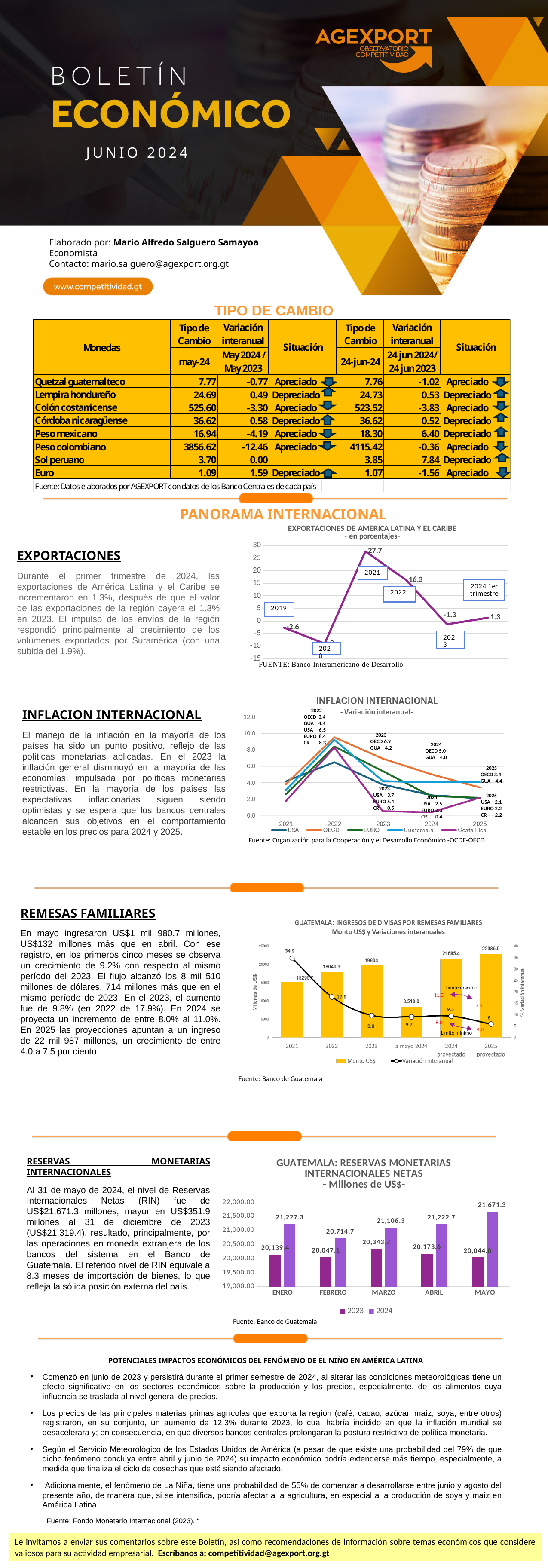
In the 'GUATEMALA: RESERVAS MONETARIAS INTERNACIONALES NETAS' chart, what is the 2024 value for MAYO? 21,671.3 In the 'EXPORTACIONES DE AMERICA LATINA Y EL CARIBE' chart, what is the value for 2023? -1.3 What kind of chart is the 'EXPORTACIONES DE AMERICA LATINA Y EL CARIBE' chart? line chart In the 'GUATEMALA: INGRESOS DE DIVISAS POR REMESAS FAMILIARES' chart, what is the Variación Interanual value for 2021? 34.9 In the 'EXPORTACIONES DE AMERICA LATINA Y EL CARIBE' chart, what is the value for 2021? 27.7 In the 'GUATEMALA: RESERVAS MONETARIAS INTERNACIONALES NETAS' chart, which month has the lowest 2024 value? FEBRERO In the 'GUATEMALA: RESERVAS MONETARIAS INTERNACIONALES NETAS' chart, how many months are shown on the x axis? 5 In the 'EXPORTACIONES DE AMERICA LATINA Y EL CARIBE' chart, which year has the highest value? 2021 In the 'GUATEMALA: INGRESOS DE DIVISAS POR REMESAS FAMILIARES' chart, what is the Monto US$ value for 2025 proyectado? 22986.5 In the 'GUATEMALA: RESERVAS MONETARIAS INTERNACIONALES NETAS' chart, what is the difference between the 2024 and 2023 values for MAYO? 1,627.3 In the 'GUATEMALA: RESERVAS MONETARIAS INTERNACIONALES NETAS' chart, which is larger: the 2023 value for MARZO or the 2023 value for ENERO? MARZO How many series does the legend of the 'INFLACION INTERNACIONAL' chart list? 5